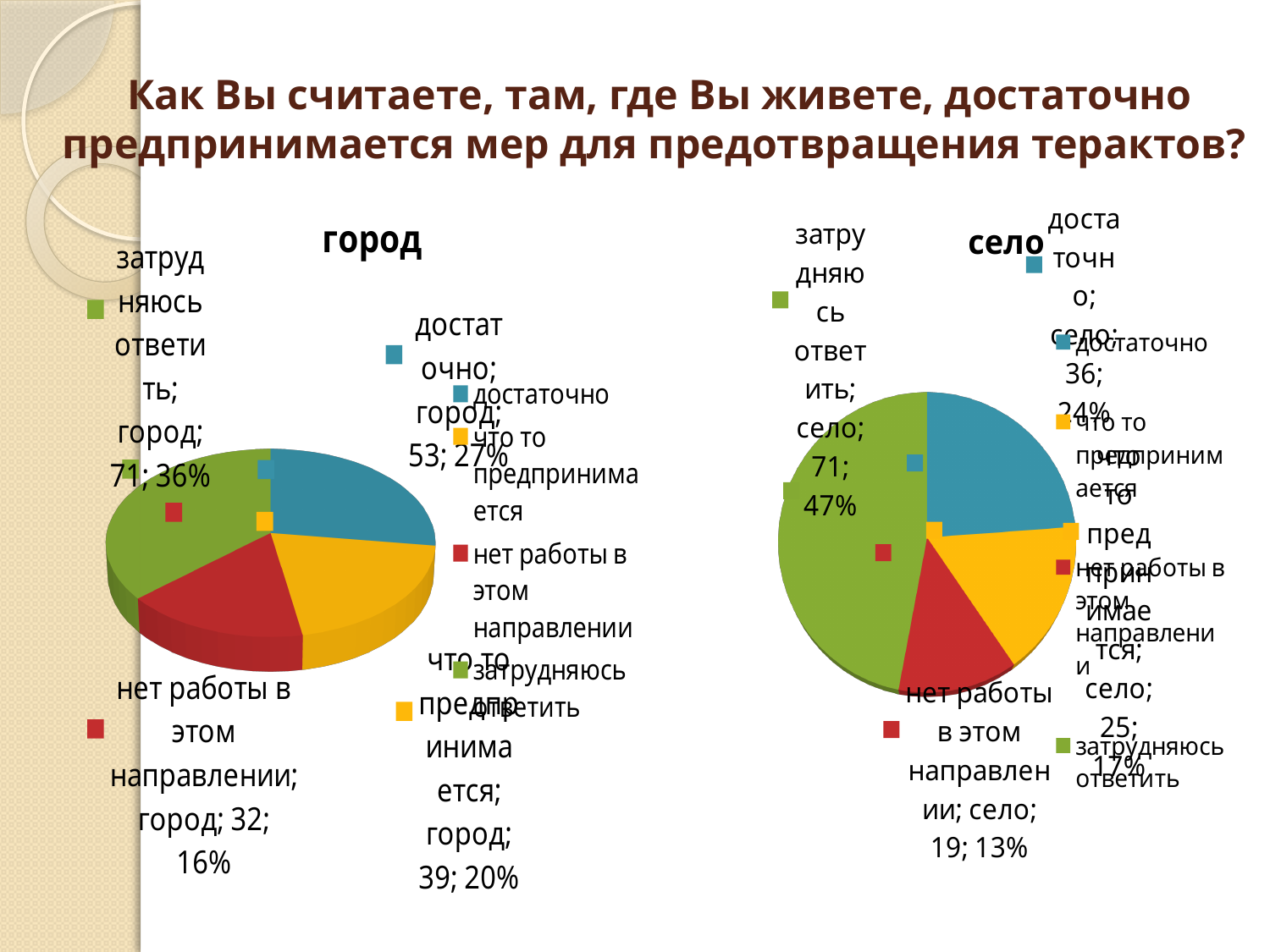
In the "город" chart, what is the difference between the values for "достаточно" and "что то предпринимается"? 14 In the "село" chart, what is the value for "нет работы в этом направлении"? 19; 13% How many entries does the legend of the "село" chart list? 4 In the "село" chart, what percentage share does "достаточно" have? 24% In the "город" chart, what percentage share does "затрудняюсь ответить" have? 36% In the "село" chart, which category has the largest value? затрудняюсь ответить In the "город" chart, which category has the smallest value? нет работы в этом направлении In the "село" chart, what is the difference between the values for "затрудняюсь ответить" and "достаточно"? 35 What type of chart is used for the "город" chart? pie chart In the "город" chart, what is the value for "достаточно"? 53; 27% In the "село" chart, which is larger: "что то предпринимается" or "нет работы в этом направлении"? что то предпринимается How many slices does the "город" chart have? 4